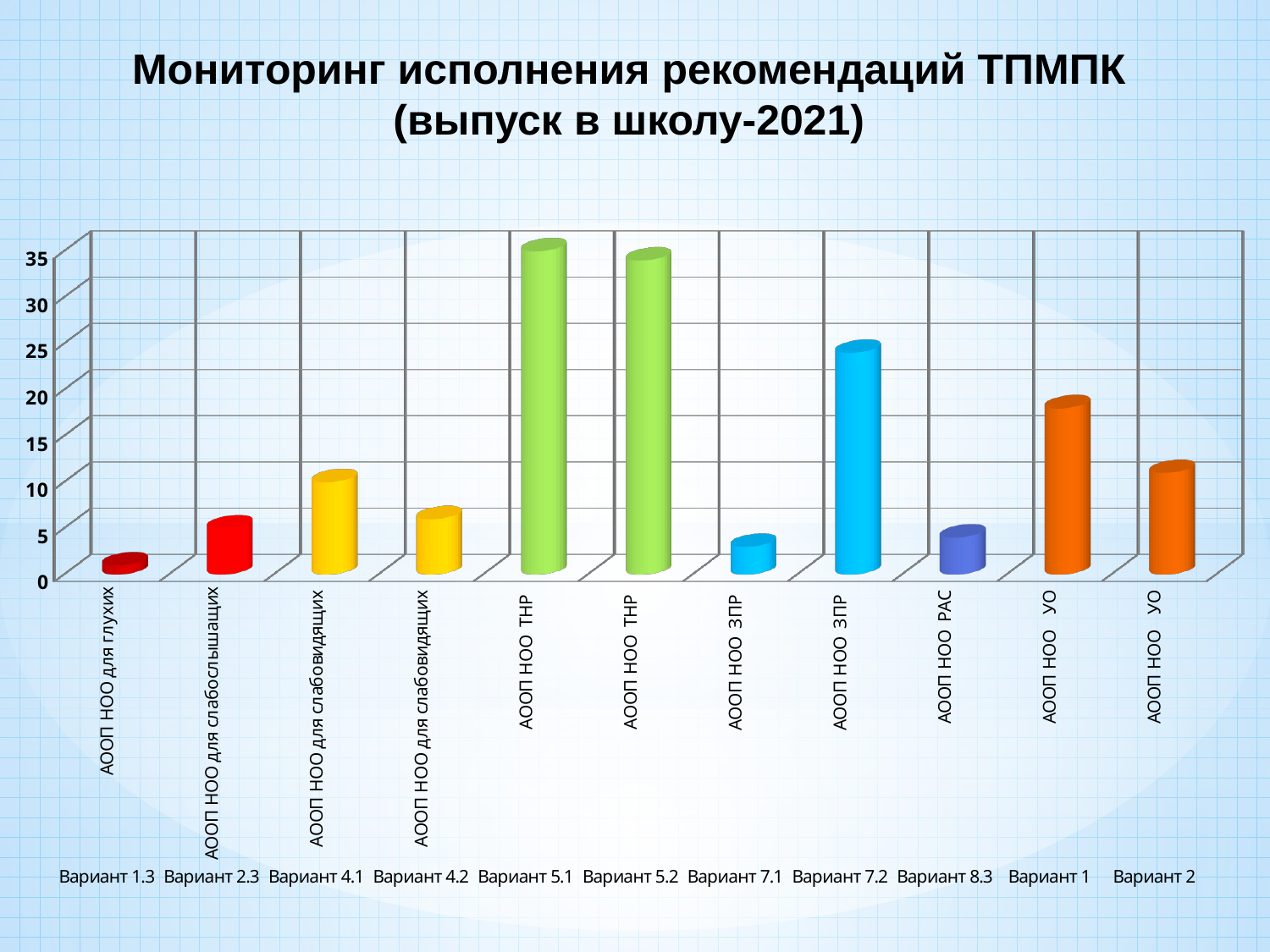
Which is larger, the value for Вариант 4.1 or the value for Вариант 4.2? Вариант 4.1 What is the title of the slide containing the chart? Мониторинг исполнения рекомендаций ТПМПК (выпуск в школу-2021) Is the value for Вариант 2.3 (АООП НОО для слабослышащих) greater or less than 10? less Is the value for Вариант 7.2 (АООП НОО ЗПР) greater or less than 20? greater Is the value for Вариант 2 (АООП НОО УО) greater or less than 15? less How many categories (варианты) are plotted on the chart? 11 What kind of chart is shown on the slide? bar chart Which is larger, the value for Вариант 7.2 or the value for Вариант 1? Вариант 7.2 Which category has the lowest value on the chart? Вариант 1.3 (АООП НОО для глухих)